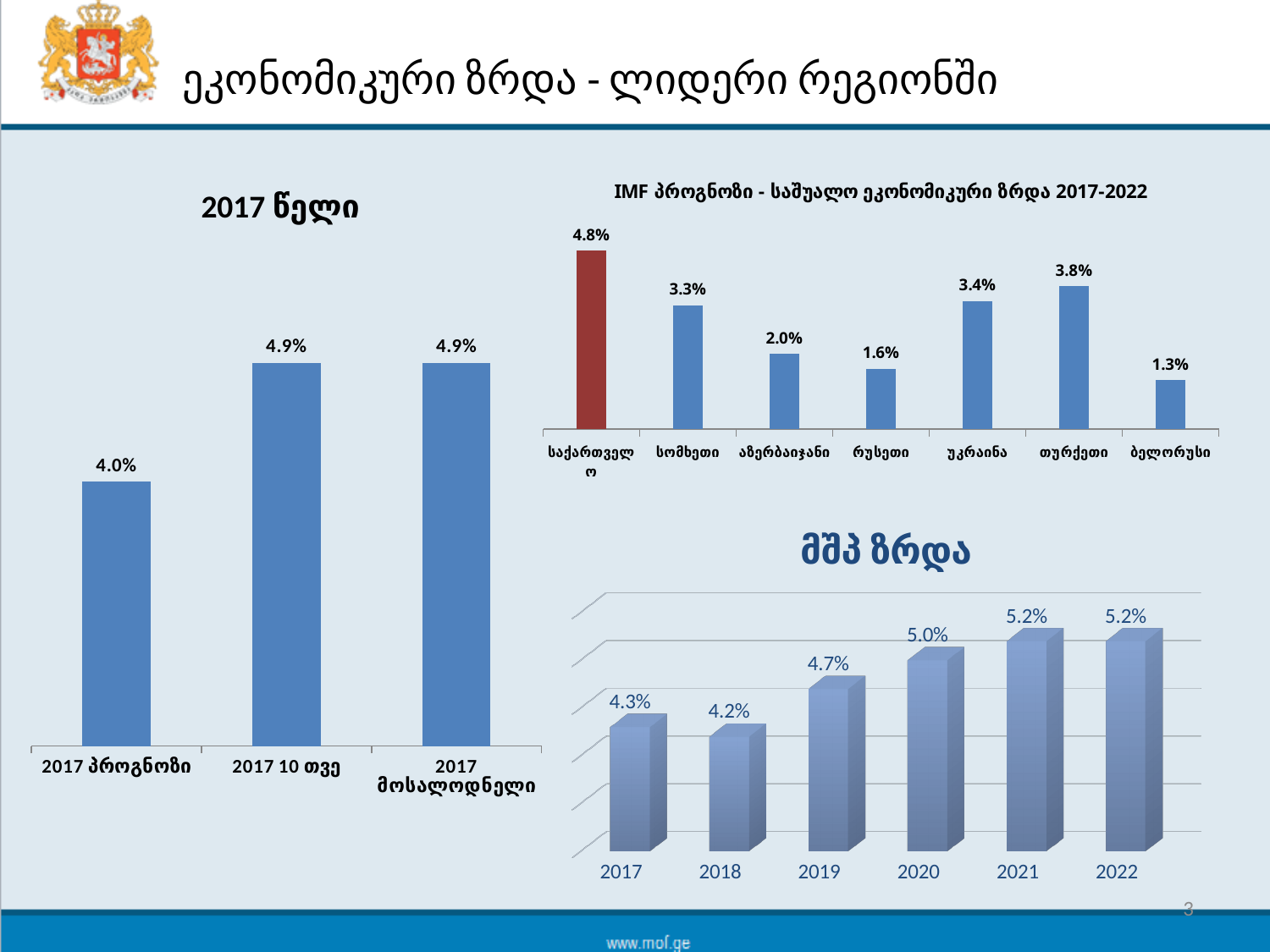
In the chart titled "2017 წელი", how many bars are plotted? 3 In the chart titled "IMF პროგნოზი - საშუალო ეკონომიკური ზრდა 2017-2022", which category has the highest value? საქართველო In the chart titled "IMF პროგნოზი - საშუალო ეკონომიკური ზრდა 2017-2022", which bar is coloured differently from the others? საქართველო In the chart titled "2017 წელი", what is the difference between the value for "2017 10 თვე" and the value for "2017 პროგნოზი"? 0.9% In the chart titled "მშპ ზრდა", what is the value for 2019? 4.7% What kind of chart is the chart titled "მშპ ზრდა"? bar chart In the chart titled "IMF პროგნოზი - საშუალო ეკონომიკური ზრდა 2017-2022", what is the value for თურქეთი? 3.8% In the chart titled "IMF პროგნოზი - საშუალო ეკონომიკური ზრდა 2017-2022", which category has the lowest value? ბელორუსი In the chart titled "2017 წელი", what is the value for "2017 პროგნოზი"? 4.0% In the chart titled "IMF პროგნოზი - საშუალო ეკონომიკური ზრდა 2017-2022", which is larger, the value for უკრაინა or the value for აზერბაიჯანი? უკრაინა In the chart titled "მშპ ზრდა", what is the difference between the value for 2022 and the value for 2017? 0.9% In the chart titled "IMF პროგნოზი - საშუალო ეკონომიკური ზრდა 2017-2022", how many countries are shown? 7